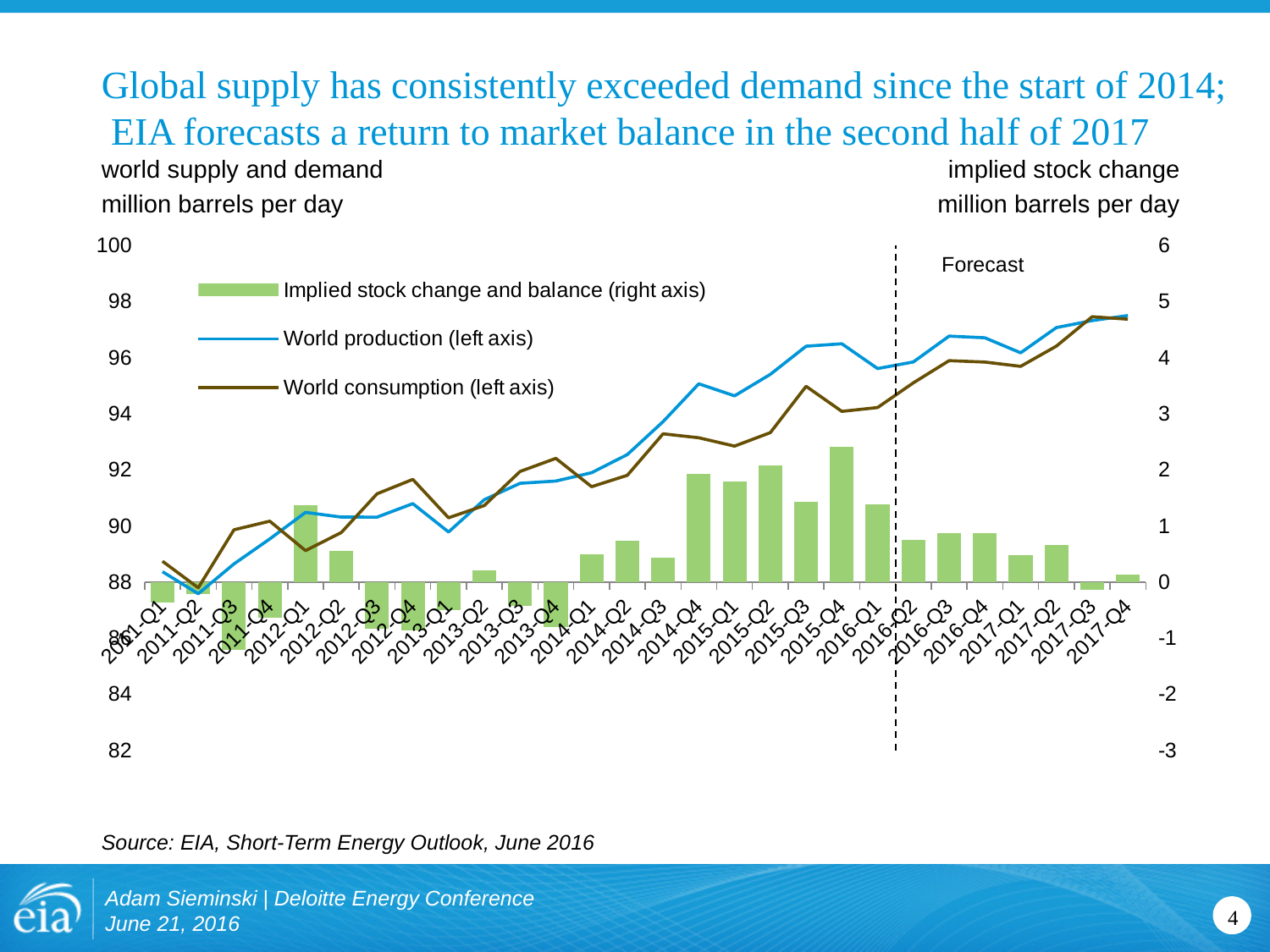
In 2015-Q3, which is larger: world production or world consumption? World production Is world consumption in 2011-Q2 greater or less than 90 million barrels per day? less In which quarter is the implied stock change bar the lowest? 2011-Q3 Does world production generally rise or fall from 2011-Q1 to 2017-Q4? Rise How many quarters are shown along the x axis of the chart? 28 Is the implied stock change for 2015-Q4 greater or less than 2 on the right axis? greater In 2011-Q3, which is larger: world production or world consumption? World consumption In which quarter is the implied stock change bar the highest? 2015-Q4 How many series does the chart legend list? 3 Is the implied stock change for 2016-Q1 greater or less than 1 on the right axis? greater What kind of chart is shown on the slide? A combination chart with bars and lines